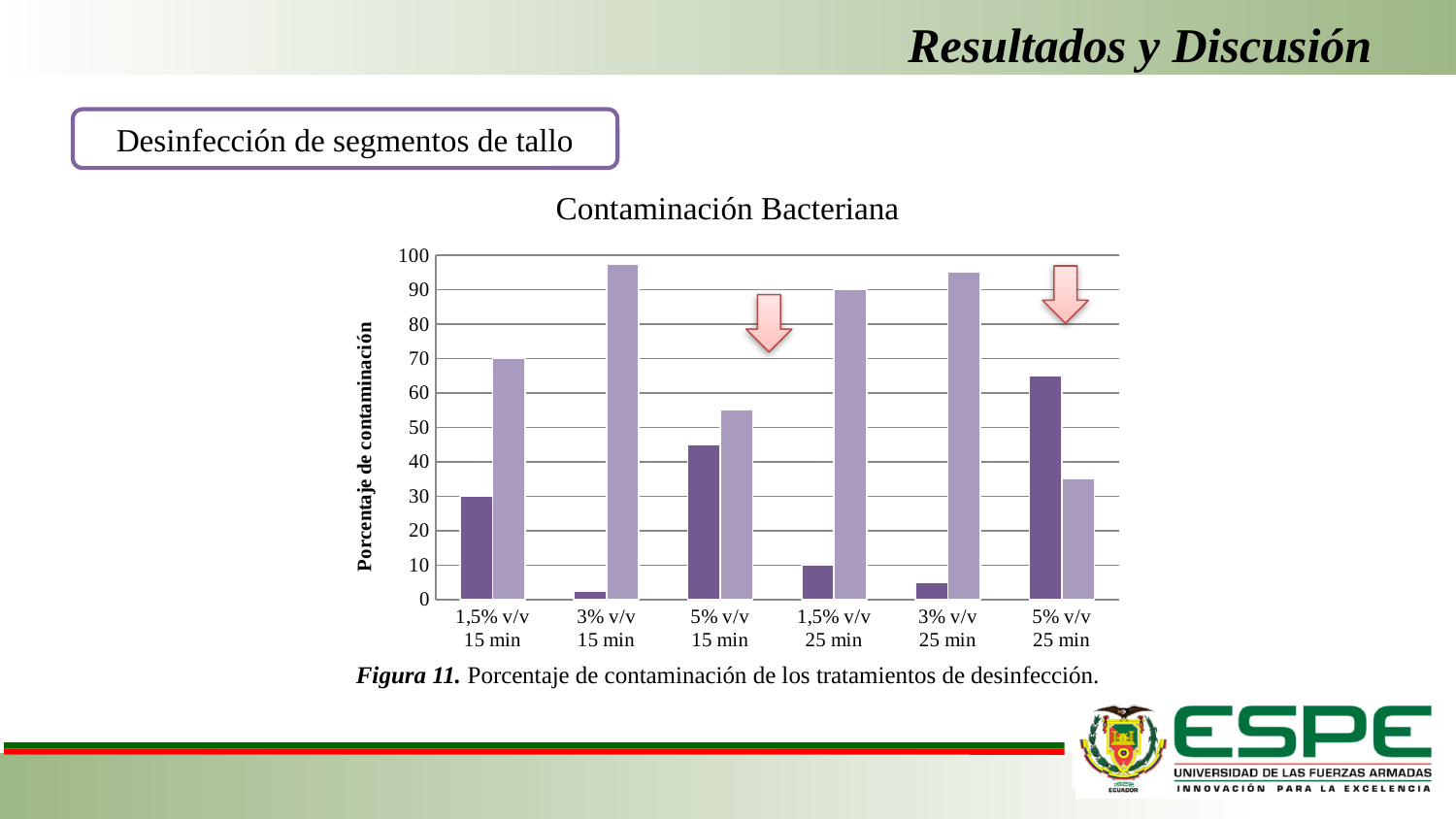
What is the value of the light purple bar for 1,5% v/v 25 min? 90 What is the difference between the light purple bar and the dark purple bar for 1,5% v/v 15 min? 40 What is the value of the dark purple bar for 1,5% v/v 15 min? 30 How many treatment categories are shown on the x axis of the chart? 6 Which treatment has the highest dark purple bar? 5% v/v 25 min What is the value of the light purple bar for 1,5% v/v 15 min? 70 Is the value of the light purple bar for 5% v/v 25 min greater or less than 40? less Is the value of the light purple bar for 3% v/v 15 min greater or less than 90? greater What kind of chart is shown on the slide? bar chart For 5% v/v 25 min, which bar is larger, the dark purple bar or the light purple bar? the dark purple bar What is the label of the vertical axis of the chart? Porcentaje de contaminación What is the title of the chart? Contaminación Bacteriana